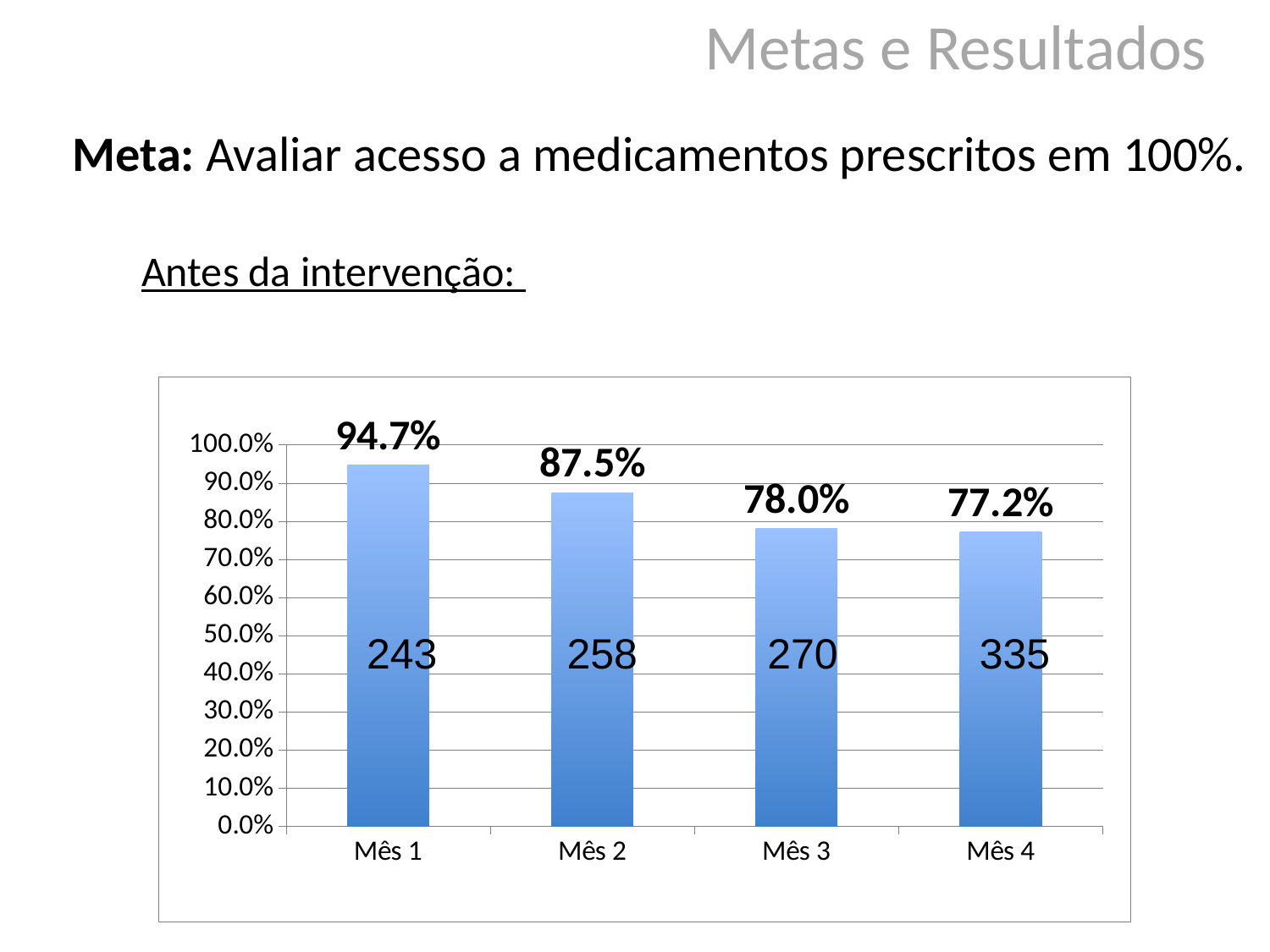
What is the heading written above the chart? Antes da intervenção: Do the percentages rise or fall from Mês 1 to Mês 4? fall Which month has the lowest percentage? Mês 4 What is the value for Mês 3? 78.0% Which month has the highest percentage? Mês 1 Which is larger, the percentage for Mês 2 or Mês 3? Mês 2 What is the value for Mês 1? 94.7% Is the value for Mês 4 greater or less than 80.0%? less What kind of chart is shown? bar chart What number is printed inside the bar for Mês 4? 335 How many months are shown on the x axis? 4 What is the difference between the percentages for Mês 1 and Mês 2? 7.2%